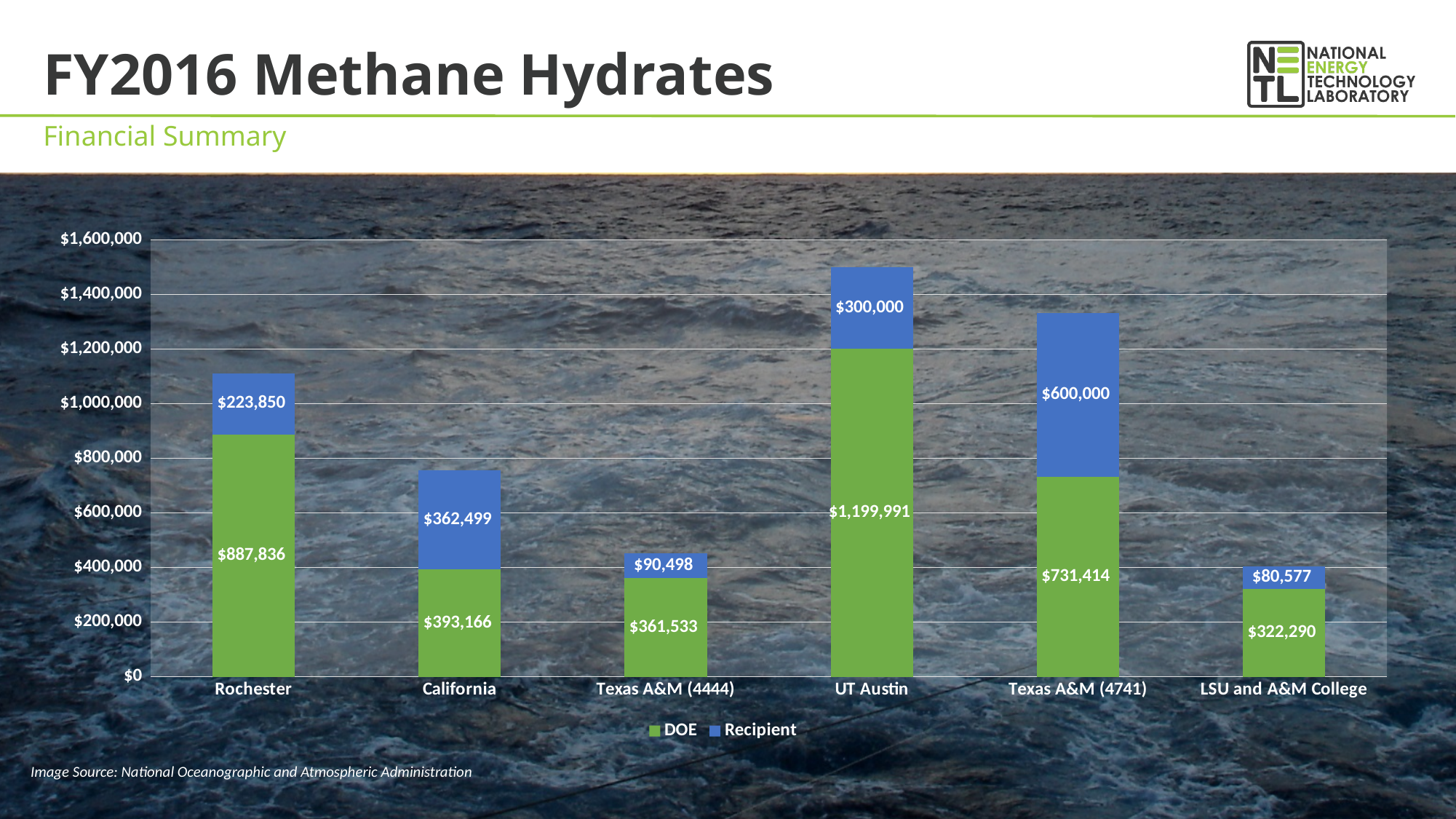
What kind of chart is shown on the slide? Stacked bar chart Which is larger, the Recipient value for California or the Recipient value for UT Austin? California What is the DOE value for UT Austin? $1,199,991 What is the difference between the DOE value for Rochester and the DOE value for California? $494,670 Which category has the lowest Recipient value? LSU and A&M College Is the total stacked value for Texas A&M (4444) greater or less than $400,000? greater How many series does the legend list? 2 What is the total stacked value for Rochester? $1,111,686 What is the Recipient value for Texas A&M (4741)? $600,000 Which category has the highest DOE value? UT Austin How many categories are shown on the x axis? 6 What is the DOE value for LSU and A&M College? $322,290